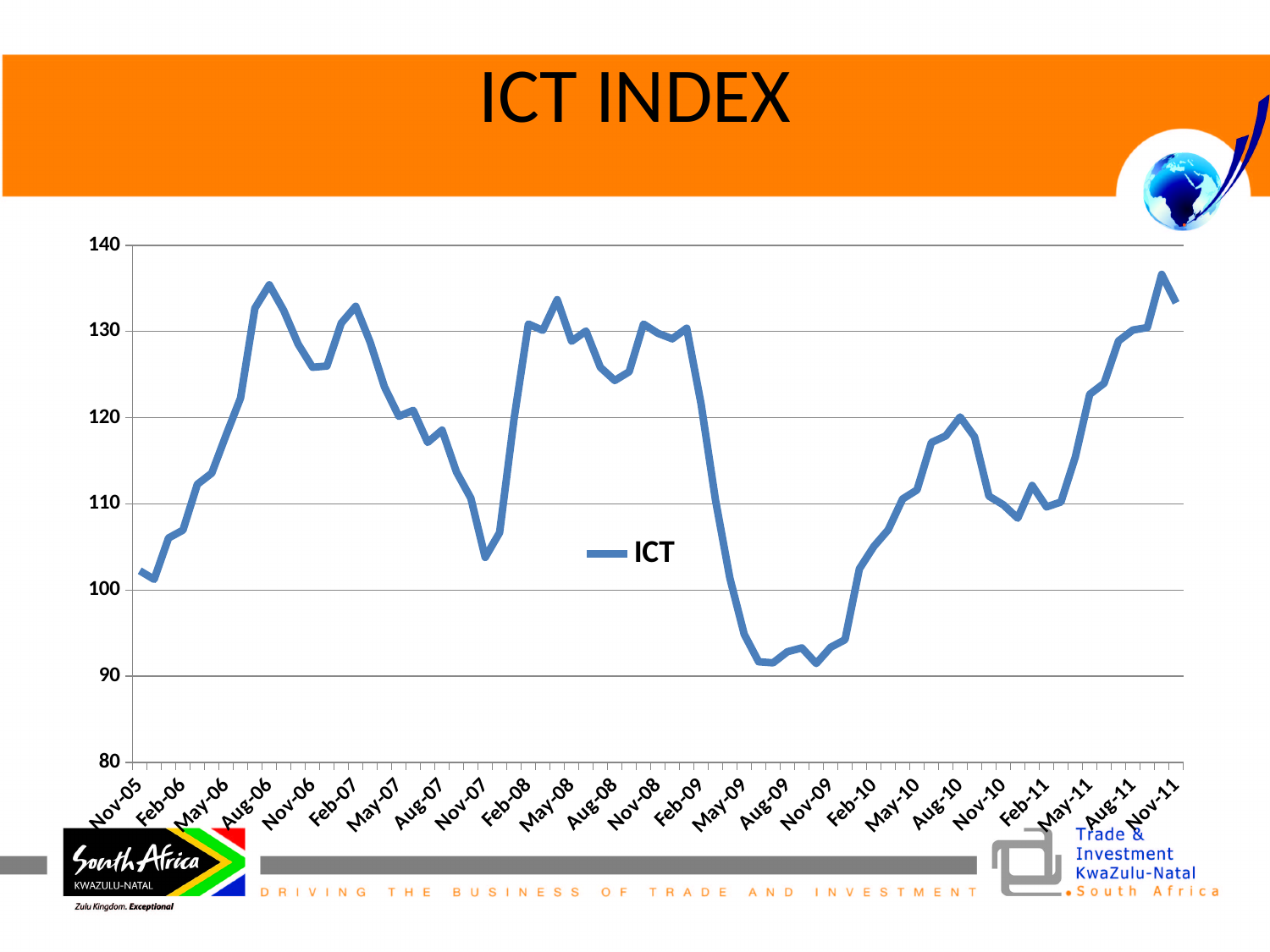
Is the value for Nov-09 greater or less than 100? less Between Feb-09 and Aug-09, does the ICT index rise or fall? fall Between Feb-11 and Nov-11, does the ICT index rise or fall? rise What is the name of the series shown in the legend? ICT Is the value for Aug-06 greater or less than 130? greater What is the title of the chart? ICT INDEX How many series does the legend list? 1 Is the value for Aug-09 greater or less than 100? less What kind of chart is shown on the slide? line chart Which is larger, the value for Aug-06 or the value for Aug-09? Aug-06